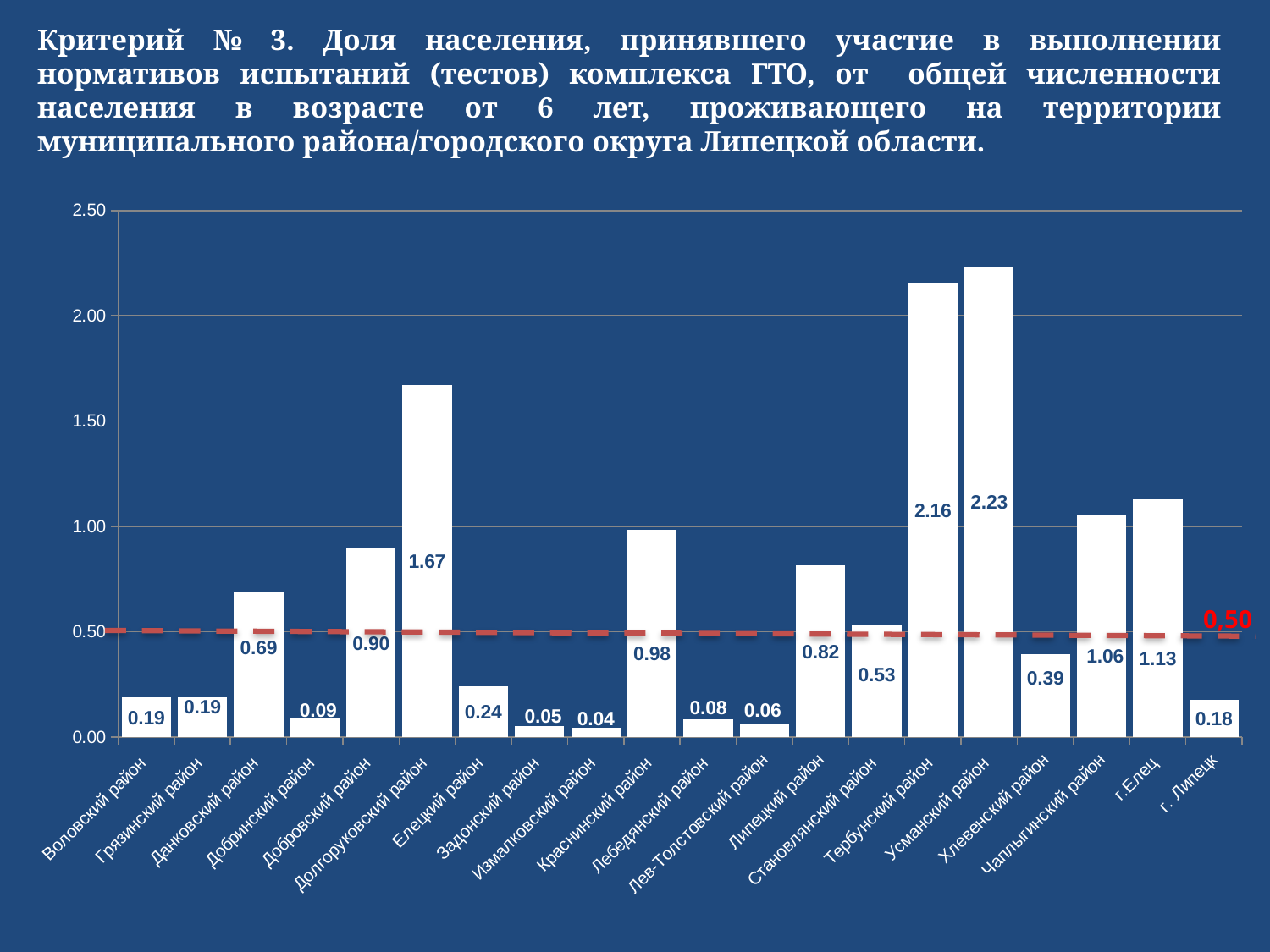
Which district has the highest value? Усманский район What is the value for Становлянский район? 0.53 What value does the red dashed horizontal line mark? 0.50 What kind of chart is shown on the slide? bar chart Is the value for Хлевенский район greater or less than 0.50? less Which is larger, the value for г.Елец or the value for Чаплыгинский район? г.Елец Which district has the lowest value? Измалковский район What is the difference between the values for Краснинский район and Липецкий район? 0.16 What is the value for Долгоруковский район? 1.67 What is the value for г. Липецк? 0.18 How many districts are shown on the x axis? 20 What is the difference between the values for Усманский район and Тербунский район? 0.07